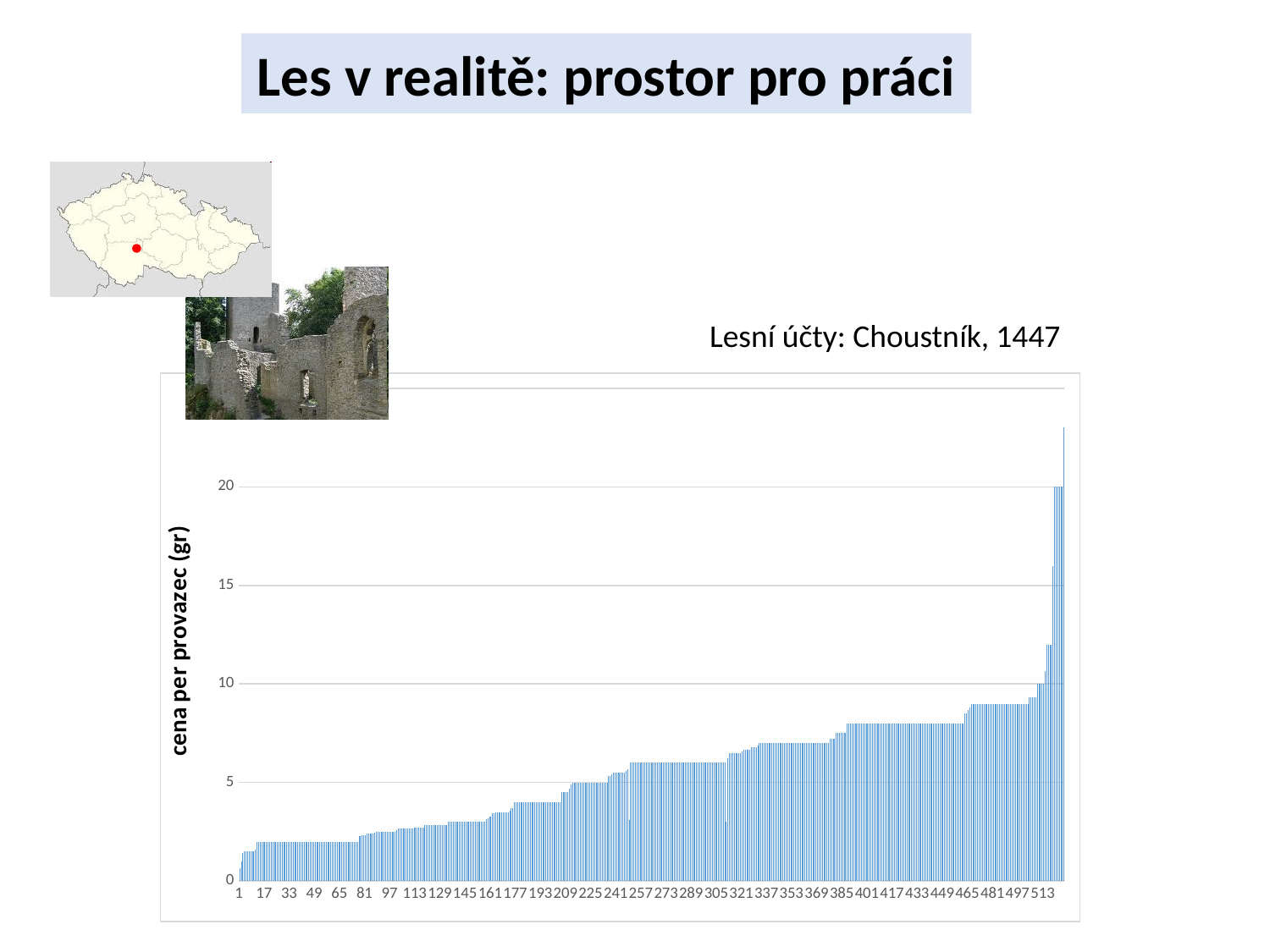
Is the value for category 257 greater or less than 10? less Is the value for category 1 greater or less than 5? less What is the highest tick value shown on the vertical axis? 20 Which is larger, the value for category 17 or the value for category 497? category 497 Is the value for category 449 greater or less than 10? less Do the bar values rise or fall from left to right along the x axis? rise What is the label of the vertical axis of the chart? cena per provazec (gr) What kind of chart is shown on the slide? bar chart